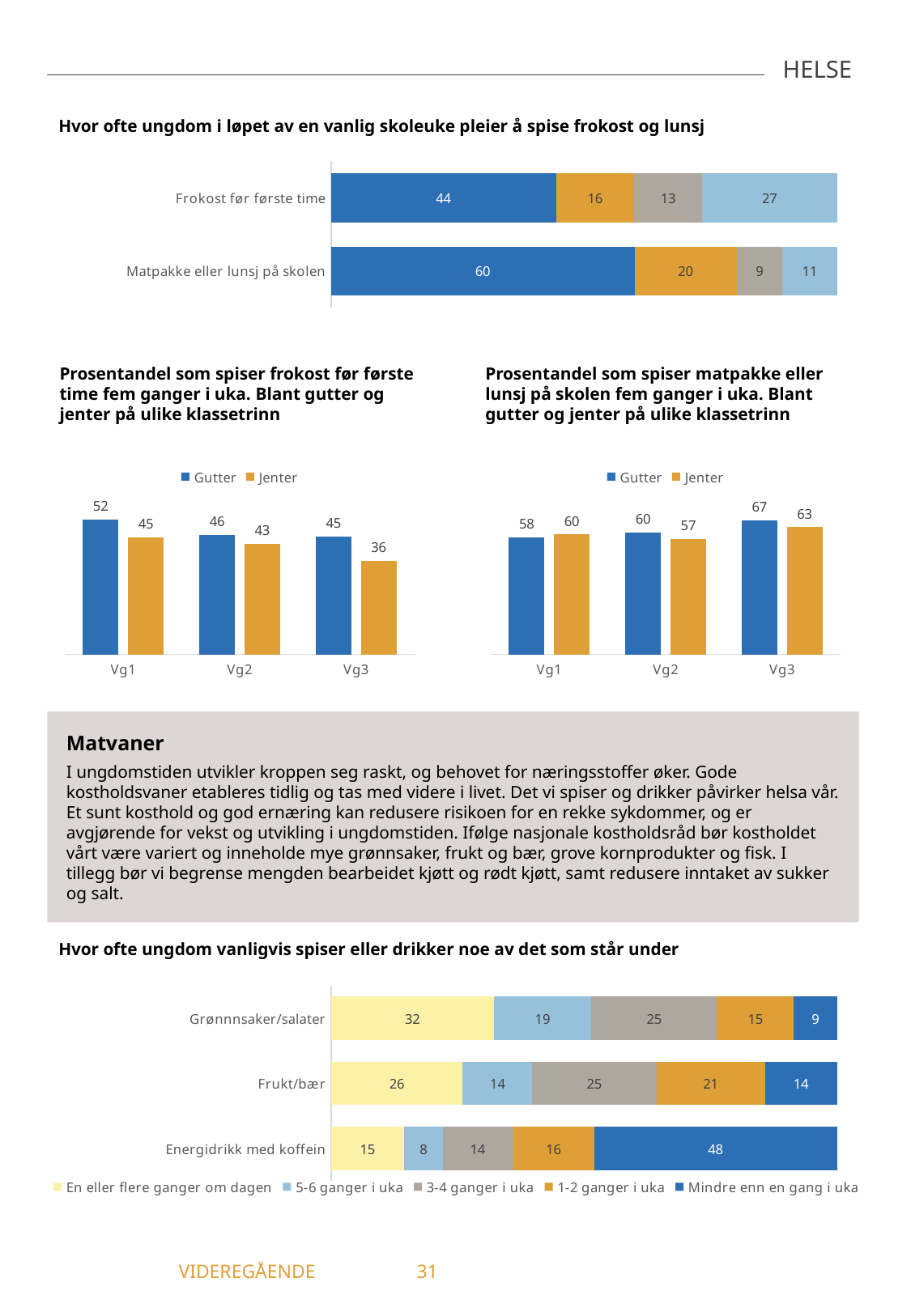
In the chart 'Prosentandel som spiser frokost før første time fem ganger i uka', what is the difference between Gutter and Jenter at Vg1? 7 What kind of chart is 'Hvor ofte ungdom vanligvis spiser eller drikker noe av det som står under'? stacked bar chart How many series does the legend list in the chart 'Prosentandel som spiser matpakke eller lunsj på skolen fem ganger i uka'? 2 In the chart 'Prosentandel som spiser frokost før første time fem ganger i uka', do the Gutter values rise or fall from Vg1 to Vg3? fall In the chart 'Hvor ofte ungdom i løpet av en vanlig skoleuke pleier å spise frokost og lunsj', what is the total of the stacked bar for 'Frokost før første time'? 100 In the chart 'Hvor ofte ungdom vanligvis spiser eller drikker noe av det som står under', what is the value for 'Mindre enn en gang i uka' for 'Energidrikk med koffein'? 48 In the chart 'Prosentandel som spiser matpakke eller lunsj på skolen fem ganger i uka', which class level has the highest value for Gutter? Vg3 In the chart 'Hvor ofte ungdom i løpet av en vanlig skoleuke pleier å spise frokost og lunsj', what is the value of the first (dark blue) segment for 'Matpakke eller lunsj på skolen'? 60 In the chart 'Prosentandel som spiser matpakke eller lunsj på skolen fem ganger i uka', which is larger at Vg1: Gutter or Jenter? Jenter In the chart 'Prosentandel som spiser frokost før første time fem ganger i uka', what is the value for Jenter at Vg3? 36 How many categories are shown in the chart 'Hvor ofte ungdom vanligvis spiser eller drikker noe av det som står under'? 3 In the chart 'Hvor ofte ungdom vanligvis spiser eller drikker noe av det som står under', which category has the highest value for 'En eller flere ganger om dagen'? Grønnnsaker/salater